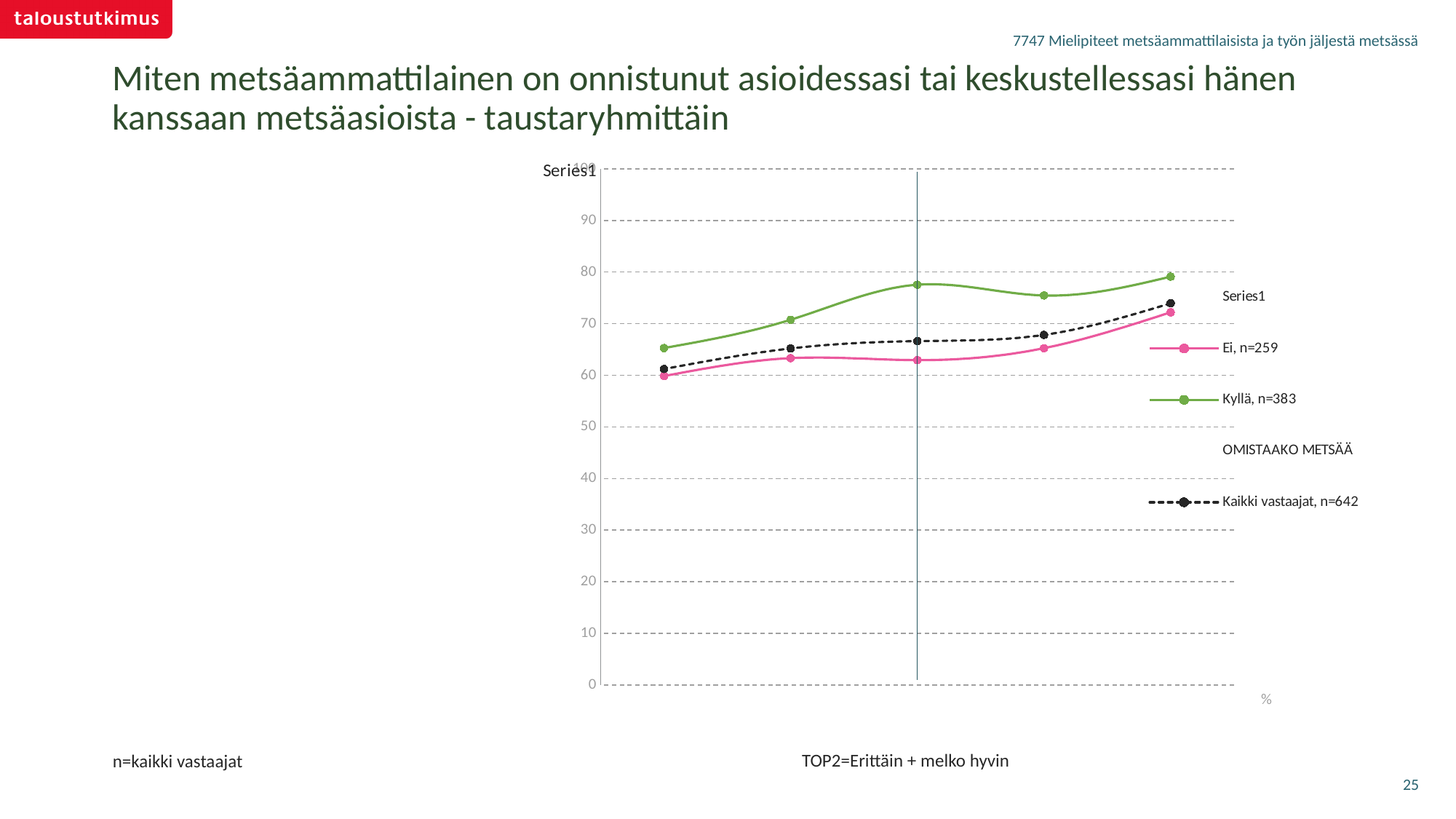
At the last point, which is larger: the 'Kyllä, n=383' value or the 'Ei, n=259' value? Kyllä, n=383 Is the value of the first point of the 'Kyllä, n=383' line greater or less than 60? greater Which series has the highest values across the chart? Kyllä, n=383 Is the value of the last point of the 'Kyllä, n=383' line greater or less than 70? greater Is the value of the middle point of the 'Ei, n=259' line greater or less than 70? less What kind of chart is shown on the slide? line chart Which series has the lowest values across the chart? Ei, n=259 How many data points does each line in the chart have? 5 Do the values of the 'Kaikki vastaajat, n=642' line generally rise or fall from left to right? rise How many data series does the chart's legend list? 5 Which series is drawn with a dashed line in the chart? Kaikki vastaajat, n=642